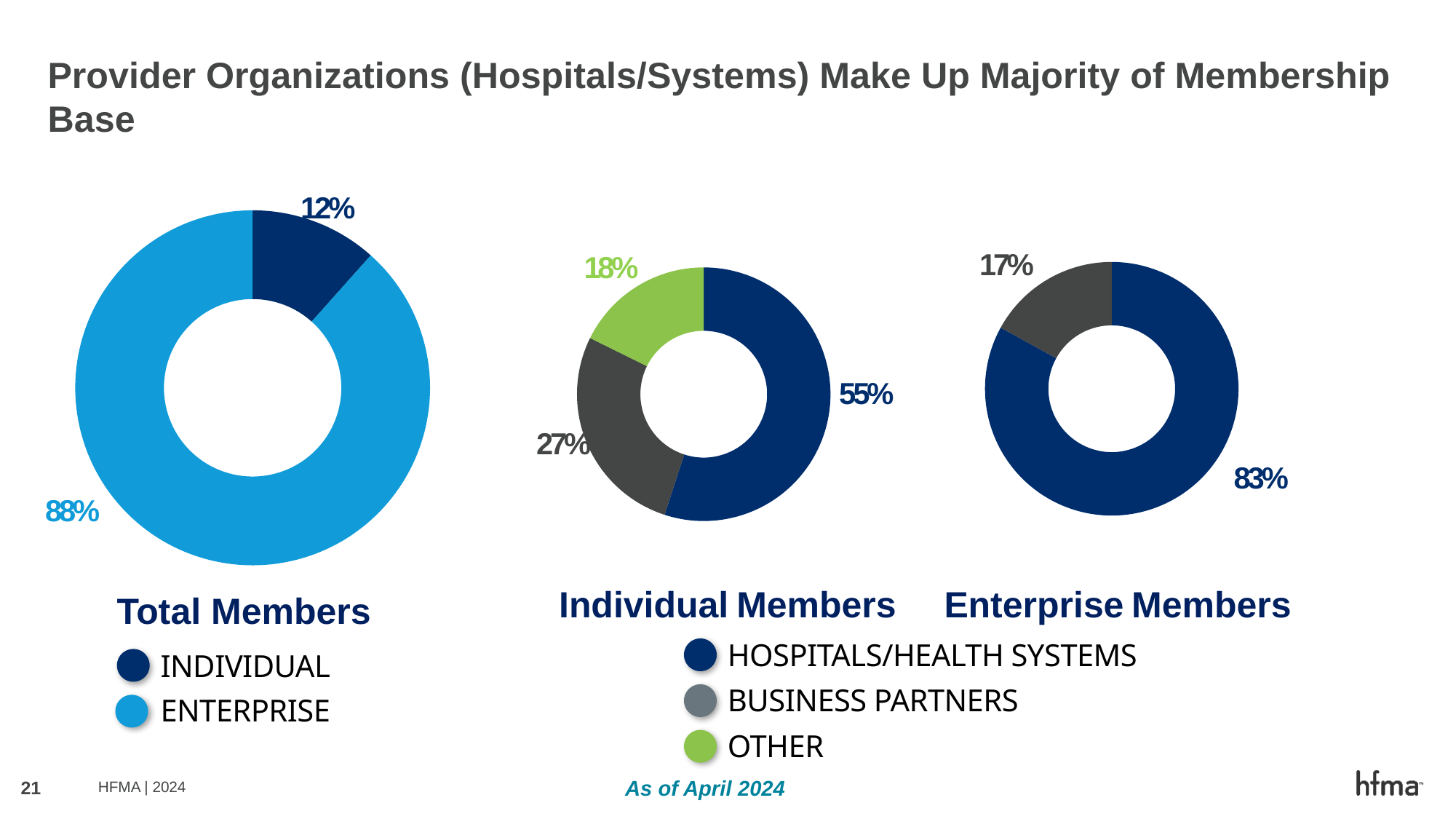
In the Individual Members chart, which category has the smallest share? Other Which is larger: the Hospitals/Health Systems share in the Enterprise Members chart or in the Individual Members chart? Enterprise Members What kind of chart is the Total Members chart? Doughnut chart In the Individual Members chart, what share is Business Partners? 27% In the Enterprise Members chart, what share is Business Partners? 17% In the Individual Members chart, what share is Other? 18% In the Total Members chart, what share of members is Individual? 12% In the Individual Members chart, what is the difference between the Hospitals/Health Systems share and the Business Partners share? 28% How many categories does the Individual Members chart show? 3 In the Individual Members chart, what share is Hospitals/Health Systems? 55% In the Enterprise Members chart, what share is Hospitals/Health Systems? 83% In the Total Members chart, what share of members is Enterprise? 88%